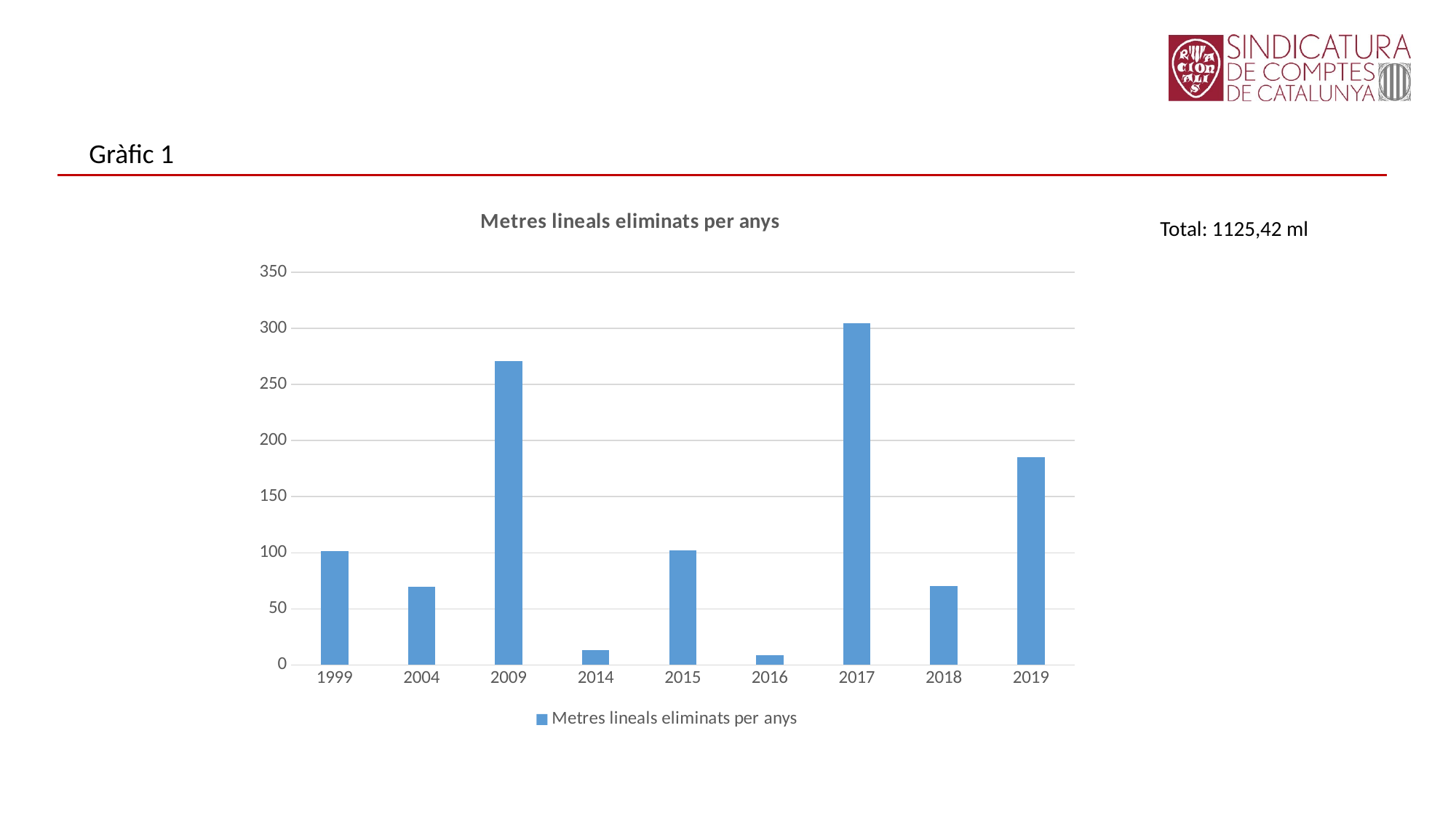
How many years are shown on the x axis of the chart? 9 Which year has the larger value, 2009 or 2017? 2017 How many series does the chart legend list? 1 Which year has the highest value in the chart? 2017 Is the value for 2019 greater or less than 200? less What total is stated next to the chart on the slide? 1125,42 ml Which year has the larger value, 2009 or 2019? 2009 Is the value for 2014 greater or less than 50? less What kind of chart is shown on the slide? bar chart Is the value for 2009 greater or less than 250? greater Which year has the lowest value in the chart? 2016 What is the title of the chart? Metres lineals eliminats per anys